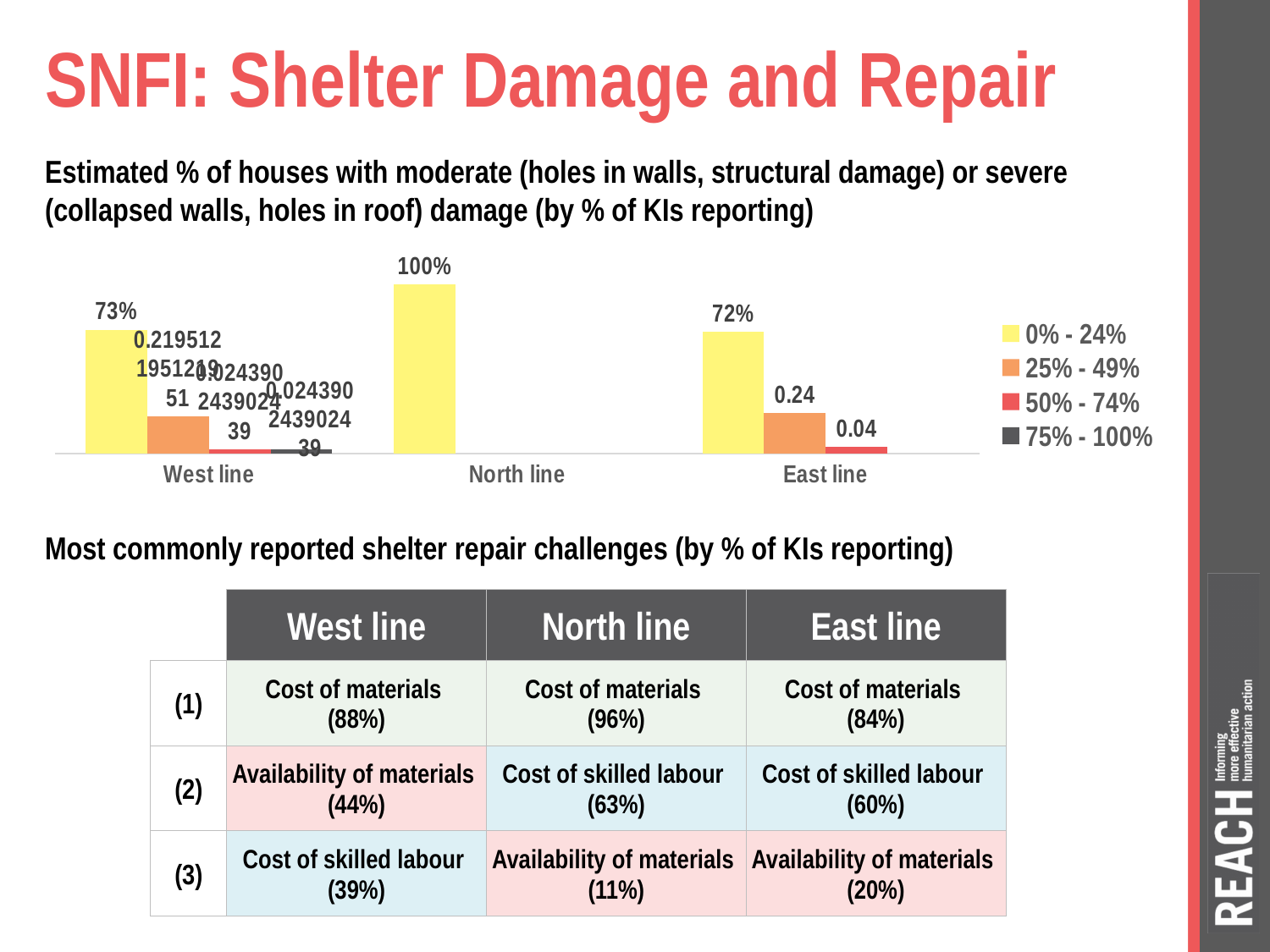
What is the value of the 0% - 24% series for East line? 72% Which category has the lowest value for the 0% - 24% series? East line What is the data label shown for the 25% - 49% series for East line? 0.24 What is the value of the 0% - 24% series for North line? 100% What type of chart is shown on the slide? bar chart Which category has the highest value for the 0% - 24% series? North line What is the value of the 0% - 24% series for West line? 73% Which colour represents the 75% - 100% series in the legend? dark grey What is the difference between the 0% - 24% values for North line and West line? 27% What is the data label shown for the 50% - 74% series for East line? 0.04 How many series does the chart legend list? 4 How many categories are shown along the x axis of the chart? 3